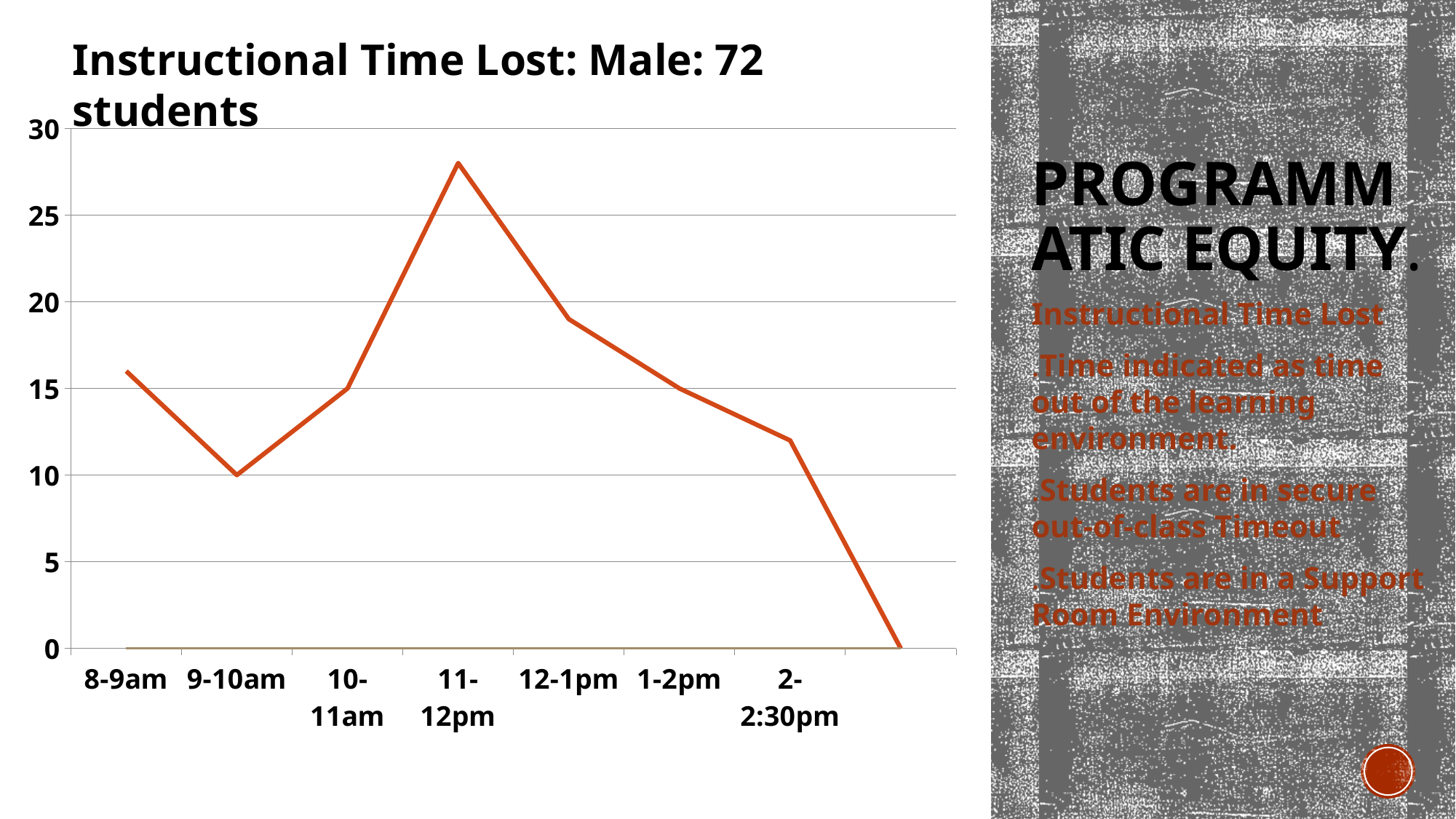
Which has a larger value, 8-9am or 9-10am? 8-9am Is the value for 2-2:30pm greater or less than 10? greater Is the value for 12-1pm greater or less than 20? less Do the values rise or fall from 11-12pm to 2-2:30pm? fall Which time slot has the highest value? 11-12pm What is the title of the chart? Instructional Time Lost: Male: 72 students How many time slots are labeled on the x axis? 7 What is the value for 10-11am? 15 Which has a larger value, 11-12pm or 12-1pm? 11-12pm What type of chart is shown on the slide? Line chart What is the value for 9-10am? 10 Is the value for 11-12pm greater or less than 25? greater